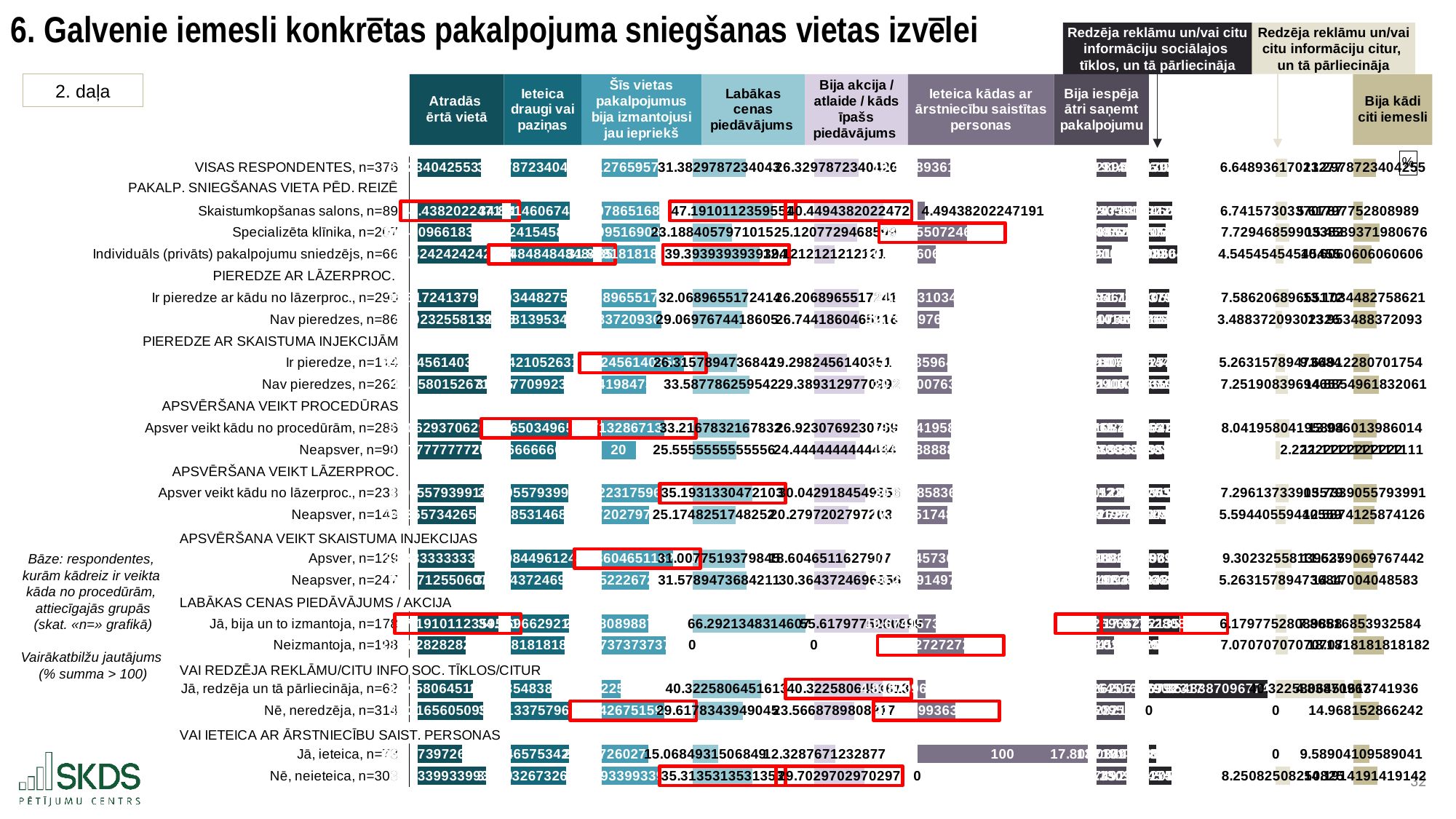
What is the value for 'Ieteica kādas ar ārstniecību saistītas personas' in the row 'Skaistumkopšanas salons, n=89'? 4.49438202247191 What kind of chart is shown on the slide? bar chart What is the value for 'Redzēja reklāmu un/vai citu informāciju sociālajos tīklos, un tā pārliecināja' in the row 'Nē, neredzēja, n=314'? 0 What is the value for 'Ieteica kādas ar ārstniecību saistītas personas' in the row 'Nē, neieteica, n=303'? 0 What is the value for 'Ieteica kādas ar ārstniecību saistītas personas' in the row 'Jā, ieteica, n=73'? 100 What is the value for 'Šīs vietas pakalpojumus bija izmantojusi jau iepriekš' in the row 'Neapsver, n=90' (under 'Apsvēršana veikt procedūras')? 20 Which row has the larger value for 'Ieteica kādas ar ārstniecību saistītas personas': 'Jā, ieteica, n=73' or 'Nē, neieteica, n=303'? Jā, ieteica, n=73 How many series (reason columns) does the chart header list? 10 What is the value for 'Bija kādi citi iemesli' in the row 'Nē, neredzēja, n=314'? 14.968152866242 What is the value for 'Bija akcija / atlaide / kāds īpašs piedāvājums' in the row 'Neizmantoja, n=198'? 0 What is the value for 'Labākas cenas piedāvājums' in the row 'Neizmantoja, n=198'? 0 What is the title of the slide's chart? %